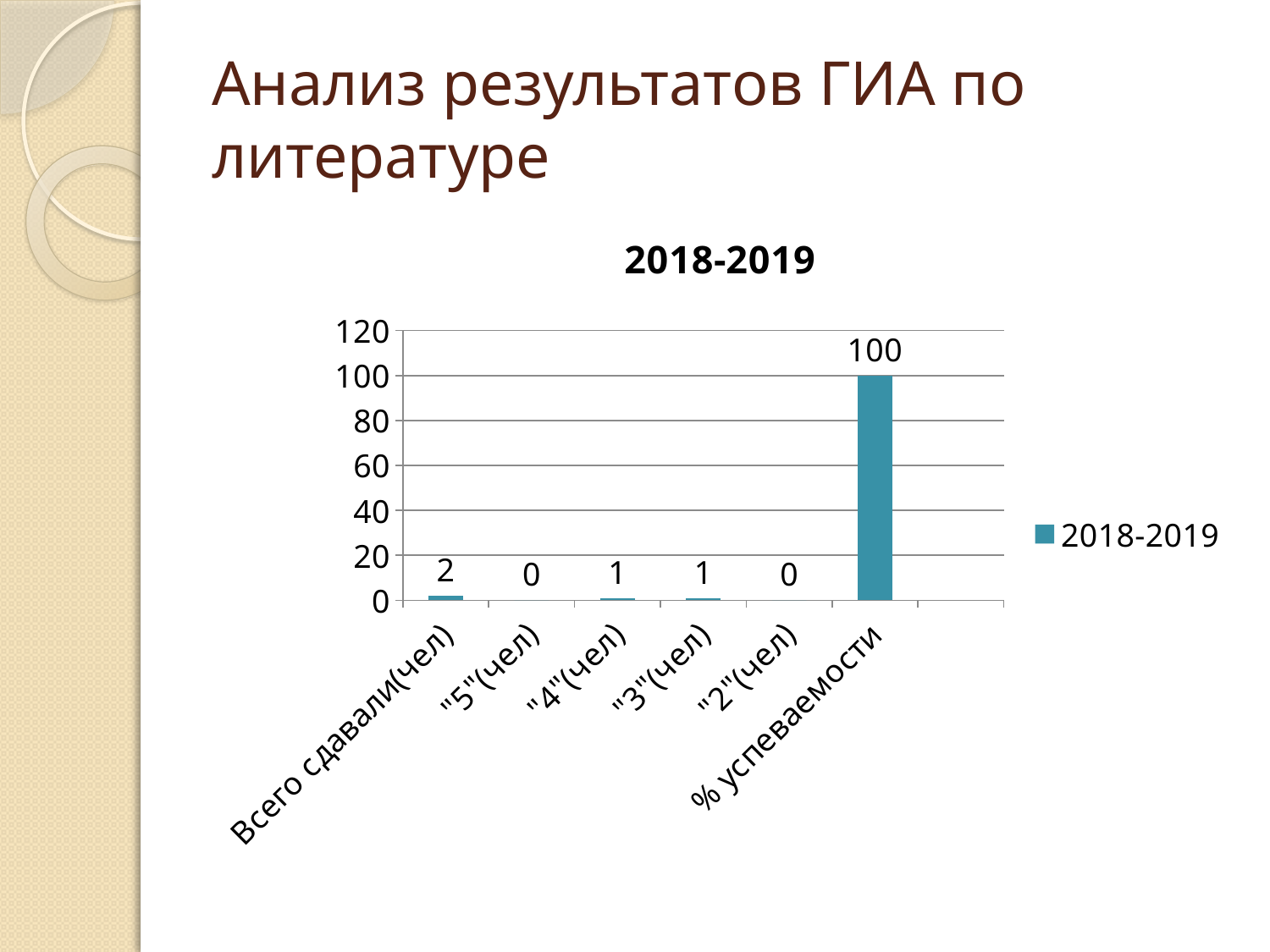
What is the value for "% успеваемости"? 100 How many series does the legend list? 1 Is the value for "% успеваемости" greater or less than 80? greater Which category has the highest value? % успеваемости What kind of chart is shown on the slide? bar chart What is the title of the chart? 2018-2019 What is the difference between the values for "Всего сдавали(чел)" and ""3"(чел)"? 1 How many categories are shown on the x axis? 6 What is the value for ""5"(чел)"? 0 What is the value for "Всего сдавали(чел)"? 2 Which is larger, the value for "Всего сдавали(чел)" or the value for ""4"(чел)"? Всего сдавали(чел) What is the value for ""4"(чел)"? 1